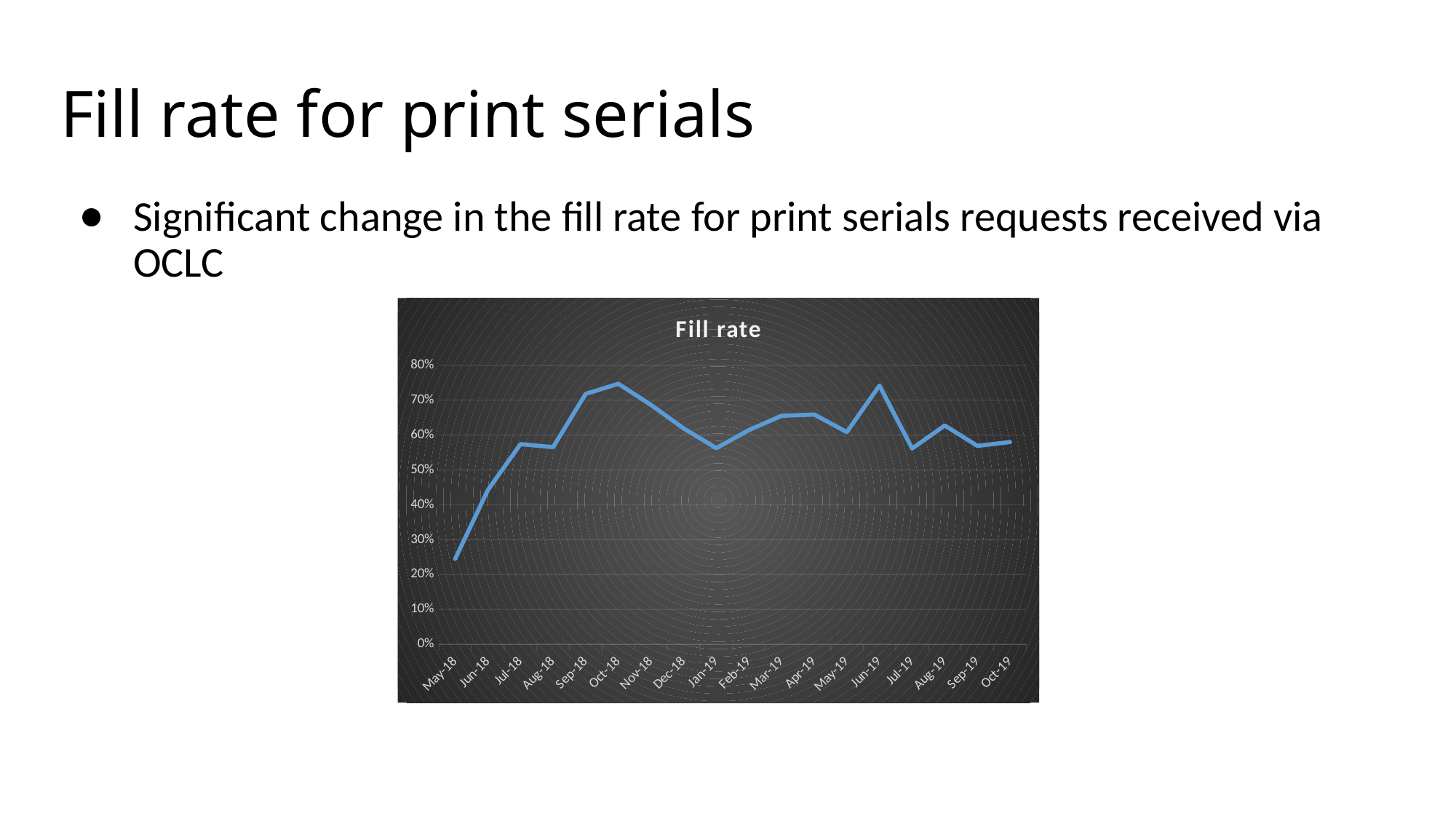
Is the fill rate for Jun-18 greater or less than 50%? less Which month has the lowest fill rate? May-18 Is the fill rate for Jun-19 greater or less than 70%? greater What is the title of the chart? Fill rate Which month has the higher fill rate, Oct-18 or Jan-19? Oct-18 Is the fill rate for May-18 greater or less than 30%? less What kind of chart is shown on the slide? line chart What is the highest value shown on the chart's vertical axis? 80% Does the fill rate rise or fall from May-18 to Oct-18? rise How many months are plotted along the x axis of the chart? 18